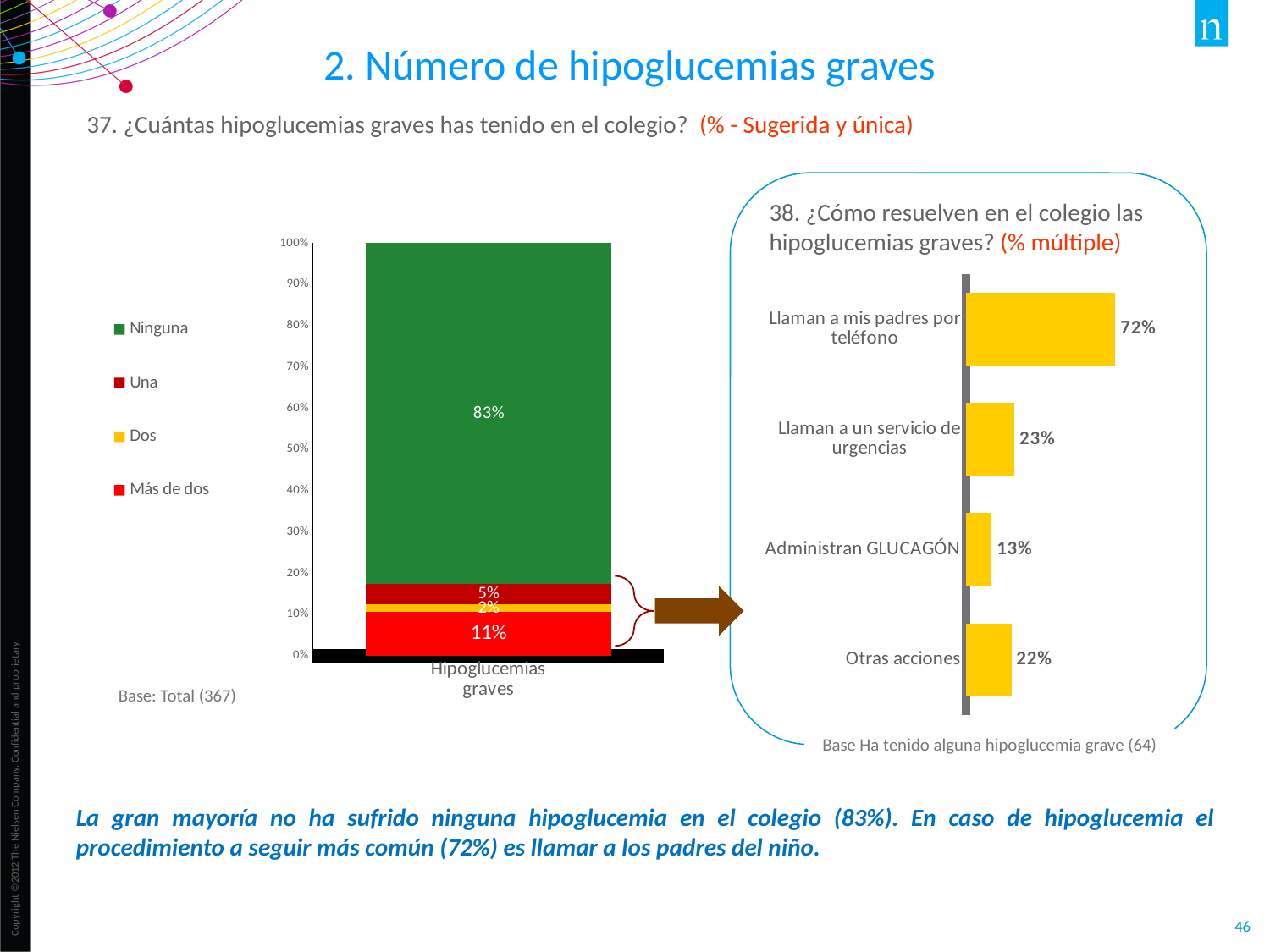
In the right chart (question 38), what percentage corresponds to 'Llaman a mis padres por teléfono'? 72% How many categories are shown in the right chart (question 38)? 4 What type of chart is the right chart (question 38)? Bar chart In the right chart (question 38), which is larger: 'Llaman a un servicio de urgencias' or 'Otras acciones'? Llaman a un servicio de urgencias In the right chart (question 38), which category has the highest value? Llaman a mis padres por teléfono In the left stacked bar chart (Hipoglucemias graves), what percentage corresponds to 'Dos'? 2% How many series does the legend of the left stacked bar chart list? 4 In the right chart (question 38), what is the difference between 'Llaman a mis padres por teléfono' and 'Llaman a un servicio de urgencias'? 49 percentage points In the left stacked bar chart (Hipoglucemias graves), what percentage corresponds to 'Ninguna'? 83% In the right chart (question 38), which category has the lowest value? Administran GLUCAGÓN In the left stacked bar chart, what is the base (sample size) shown below the chart? Total (367) In the right chart (question 38), what is the value for 'Administran GLUCAGÓN'? 13%